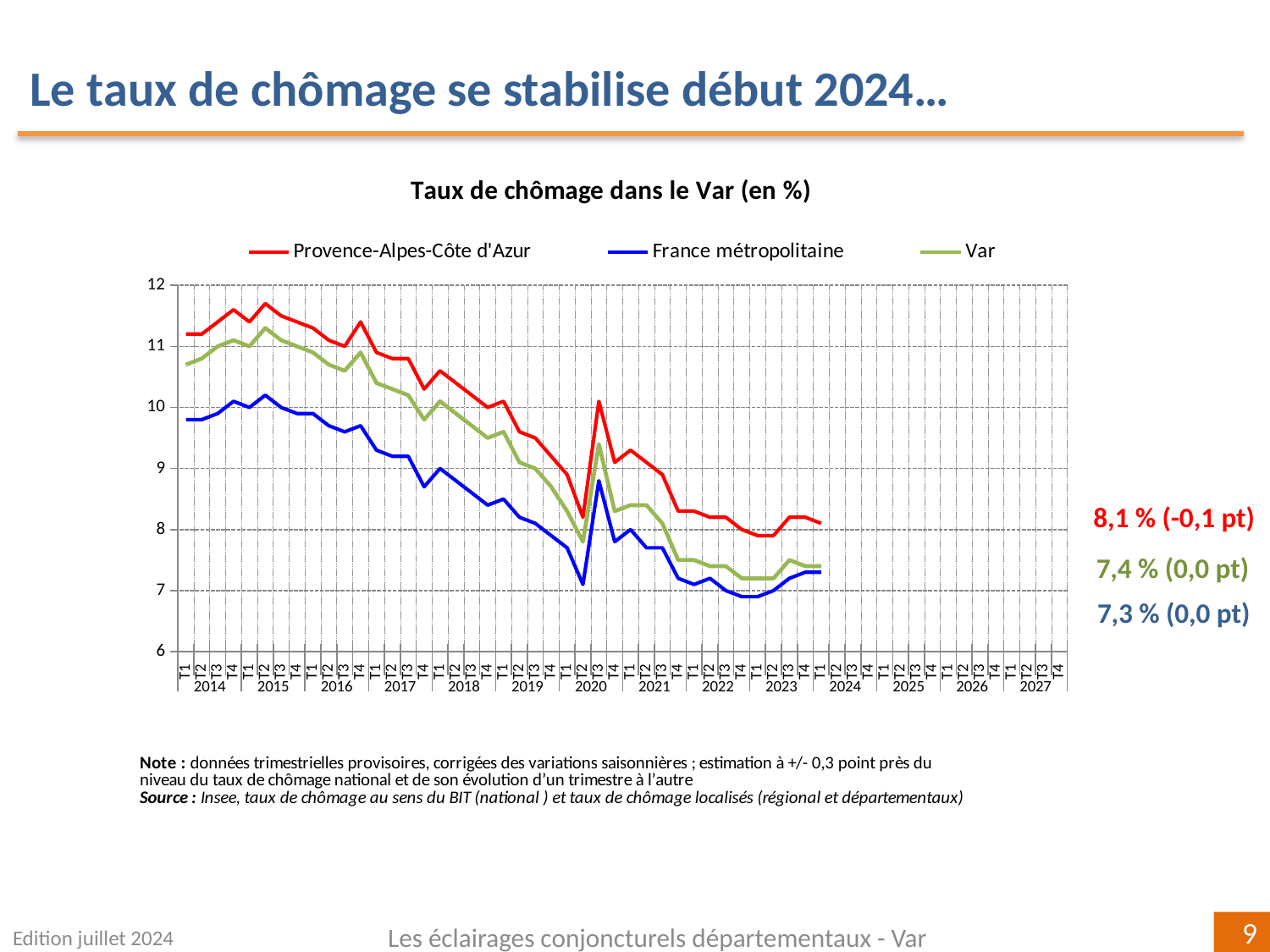
What kind of chart is shown on the slide? line chart What is the quarterly change shown for Provence-Alpes-Côte d'Azur at the latest point? -0,1 pt What is the latest unemployment rate shown for France métropolitaine? 7,3 % What is the difference between the latest rates for Provence-Alpes-Côte d'Azur and France métropolitaine? 0,8 Overall, do the unemployment rates rise or fall from 2014 to 2024? fall Is the value for Provence-Alpes-Côte d'Azur in T2 2015 greater or less than 11? greater Which series has the highest value at the latest point? Provence-Alpes-Côte d'Azur How many series does the legend list? 3 What is the latest unemployment rate shown for Provence-Alpes-Côte d'Azur? 8,1 % What is the title of the chart? Taux de chômage dans le Var (en %) Which series has the lowest value at the latest point? France métropolitaine What is the latest unemployment rate shown for Var? 7,4 %